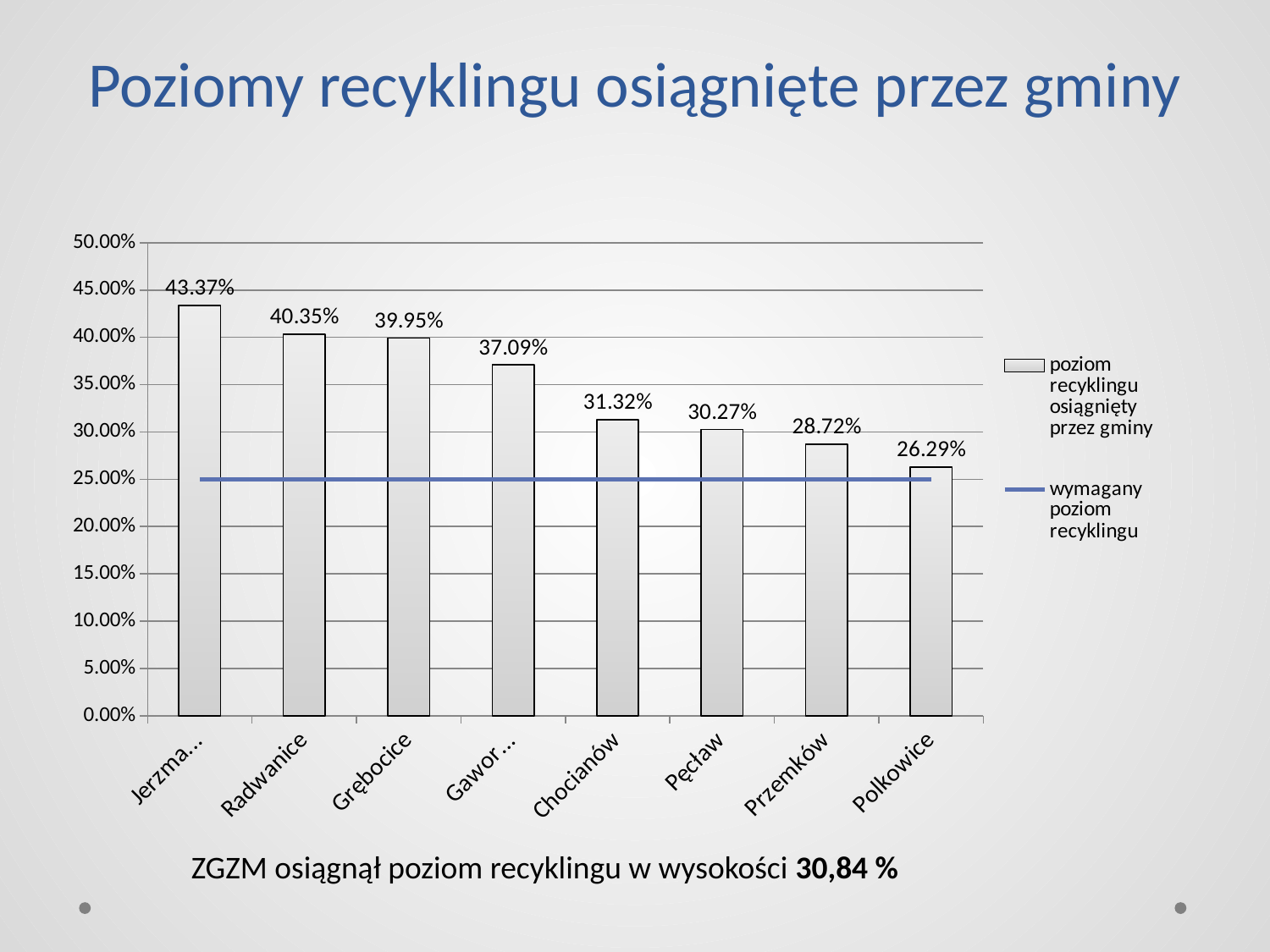
What is the value for Przemków? 28.72% What kind of chart is shown on the slide? combination bar and line chart Which municipality has the lowest recycling level on the chart? Polkowice What is the difference between the values for Grębocice and Pęcław? 9.68% Do the bar values rise or fall from left to right along the x axis? fall What recycling level did Radwanice achieve? 40.35% How many municipalities (bars) are shown on the chart? 8 Which has a higher recycling level, Radwanice or Chocianów? Radwanice Is the value for Pęcław greater or less than 25.00%? greater What is the value shown for Polkowice? 26.29% How many series does the legend list? 2 What recycling level is shown for Chocianów? 31.32%